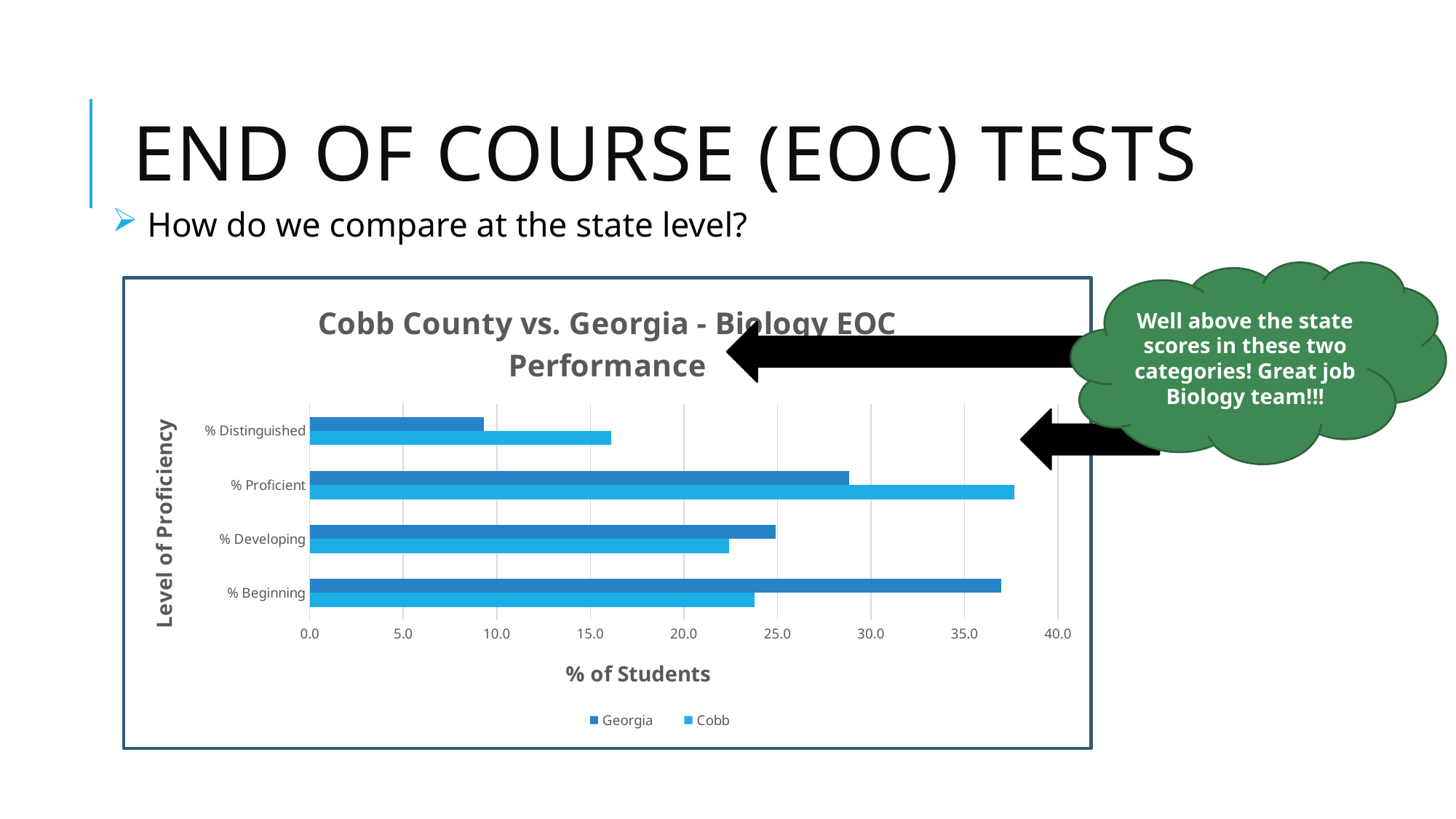
For % Distinguished, which is larger, Georgia or Cobb? Cobb Is the Georgia value for % Beginning greater or less than 35.0? greater Which proficiency level has the highest value for Cobb? % Proficient Is the Georgia value for % Distinguished greater or less than 10.0? less For % Proficient, which is larger, Georgia or Cobb? Cobb What is the title of the horizontal axis? % of Students How many proficiency levels are plotted on the chart? 4 Which proficiency level has the lowest value for Georgia? % Distinguished What kind of chart is shown on the slide? bar chart Which proficiency level has the highest value for Georgia? % Beginning For % Beginning, which is larger, Georgia or Cobb? Georgia How many series does the chart legend list? 2